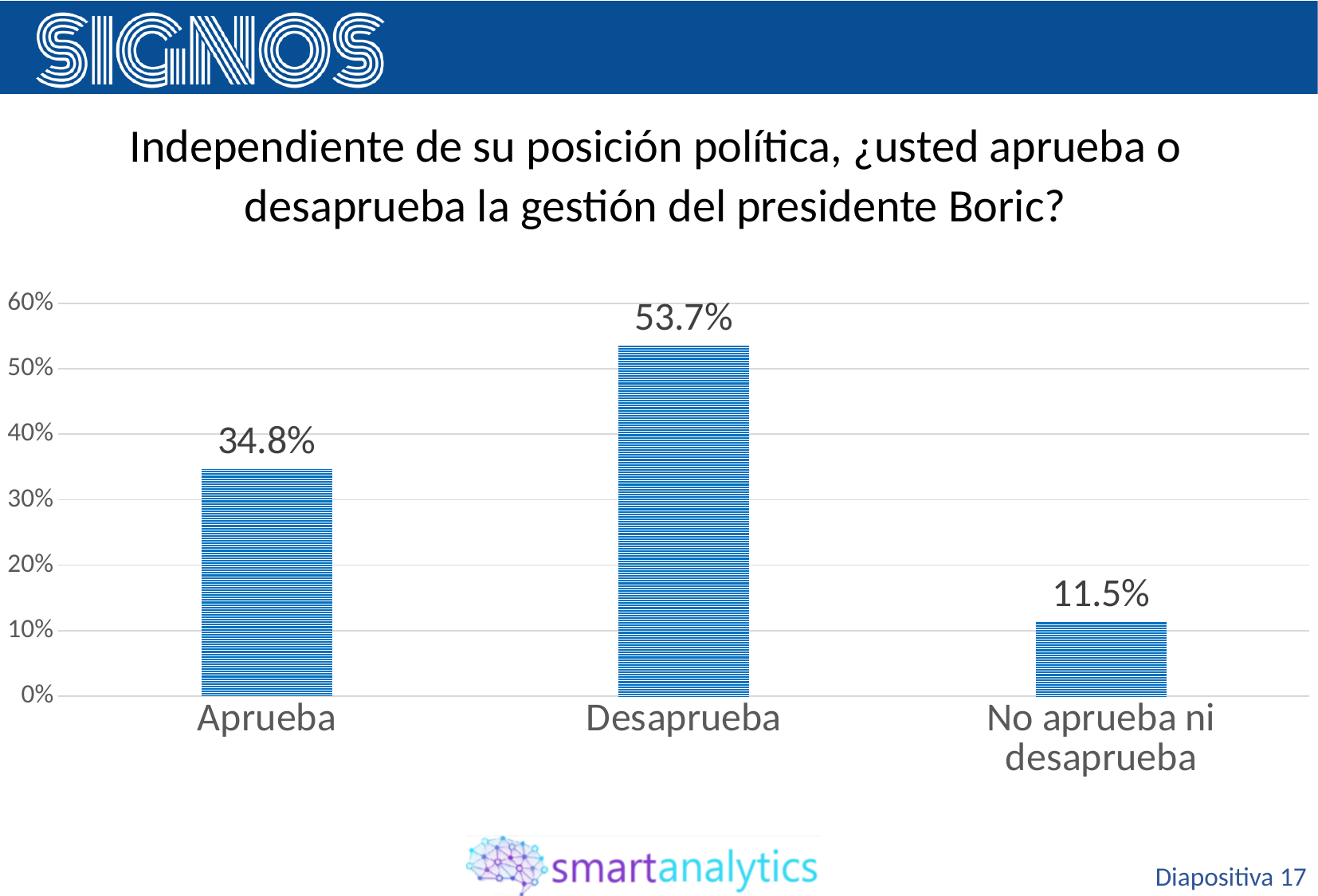
Which category has the lowest value? No aprueba ni desaprueba What is the difference between Aprueba and No aprueba ni desaprueba? 23.3% What kind of chart is shown on the slide? Bar chart What is the highest value shown on the vertical axis? 60% What is the value for Aprueba? 34.8% What is the value for Desaprueba? 53.7% Is the value for Aprueba greater or less than 30%? greater What is the value for No aprueba ni desaprueba? 11.5% Which category has the highest value? Desaprueba How many categories are shown in the chart? 3 What is the difference between Desaprueba and Aprueba? 18.9% Which is larger, Aprueba or Desaprueba? Desaprueba